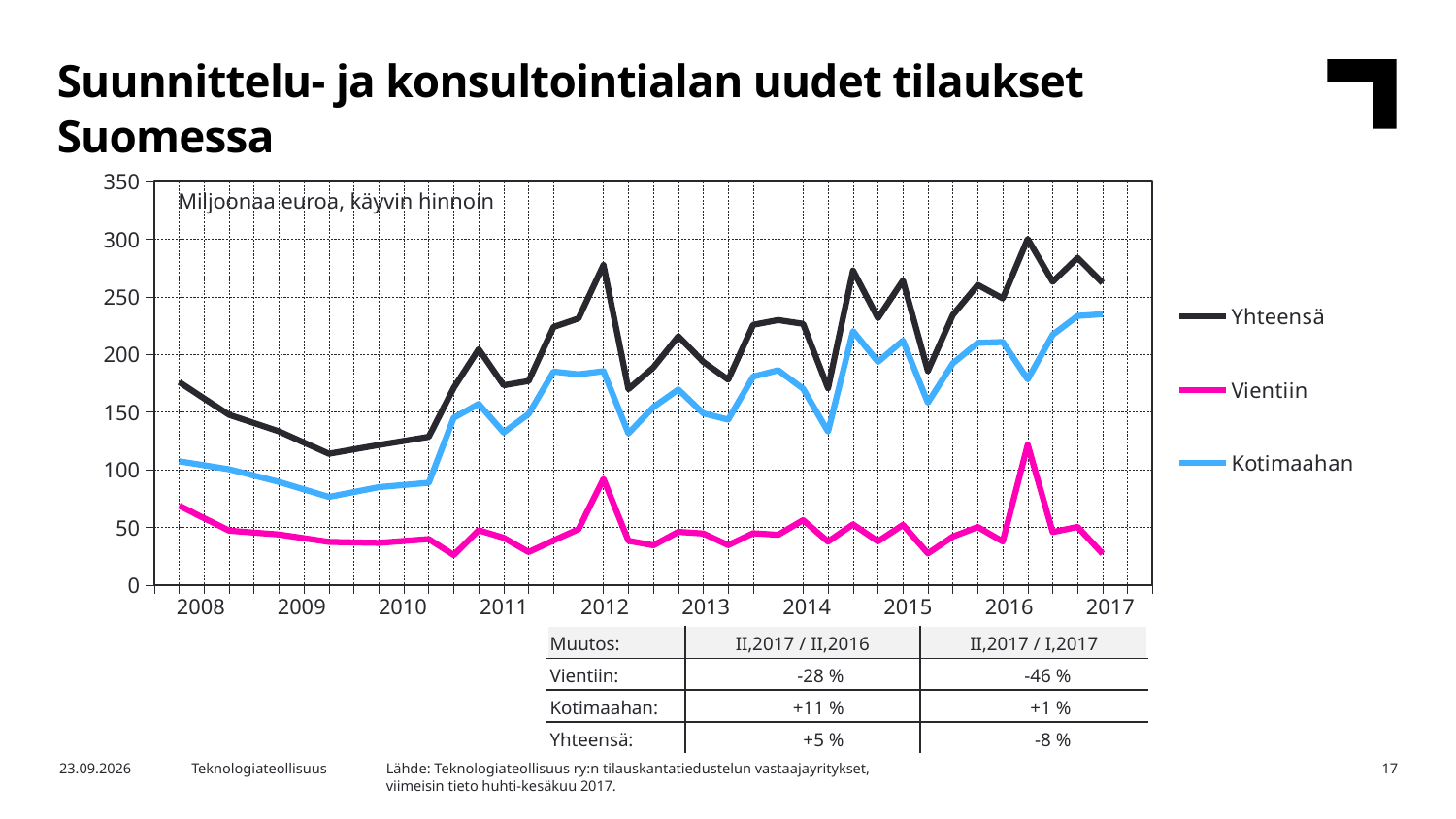
Is the value of Kotimaahan at the 2009 low point greater or less than 100? less How many year labels are shown on the x axis? 10 Which series has the lowest values throughout the chart? Vientiin What kind of chart is shown on the slide? line chart Which series are listed in the legend? Yhteensä, Vientiin, Kotimaahan What unit note is printed inside the chart area? Miljoonaa euroa, käyvin hinnoin Which series has the highest values throughout the chart? Yhteensä Does the Yhteensä line rise or fall from 2008 to 2009? fall How many series does the legend list? 3 Is the peak value of Yhteensä around 2012 greater or less than 250? greater At the end of the series in 2017, which is larger, Kotimaahan or Vientiin? Kotimaahan Is the peak value of Vientiin around 2016 greater or less than 100? greater